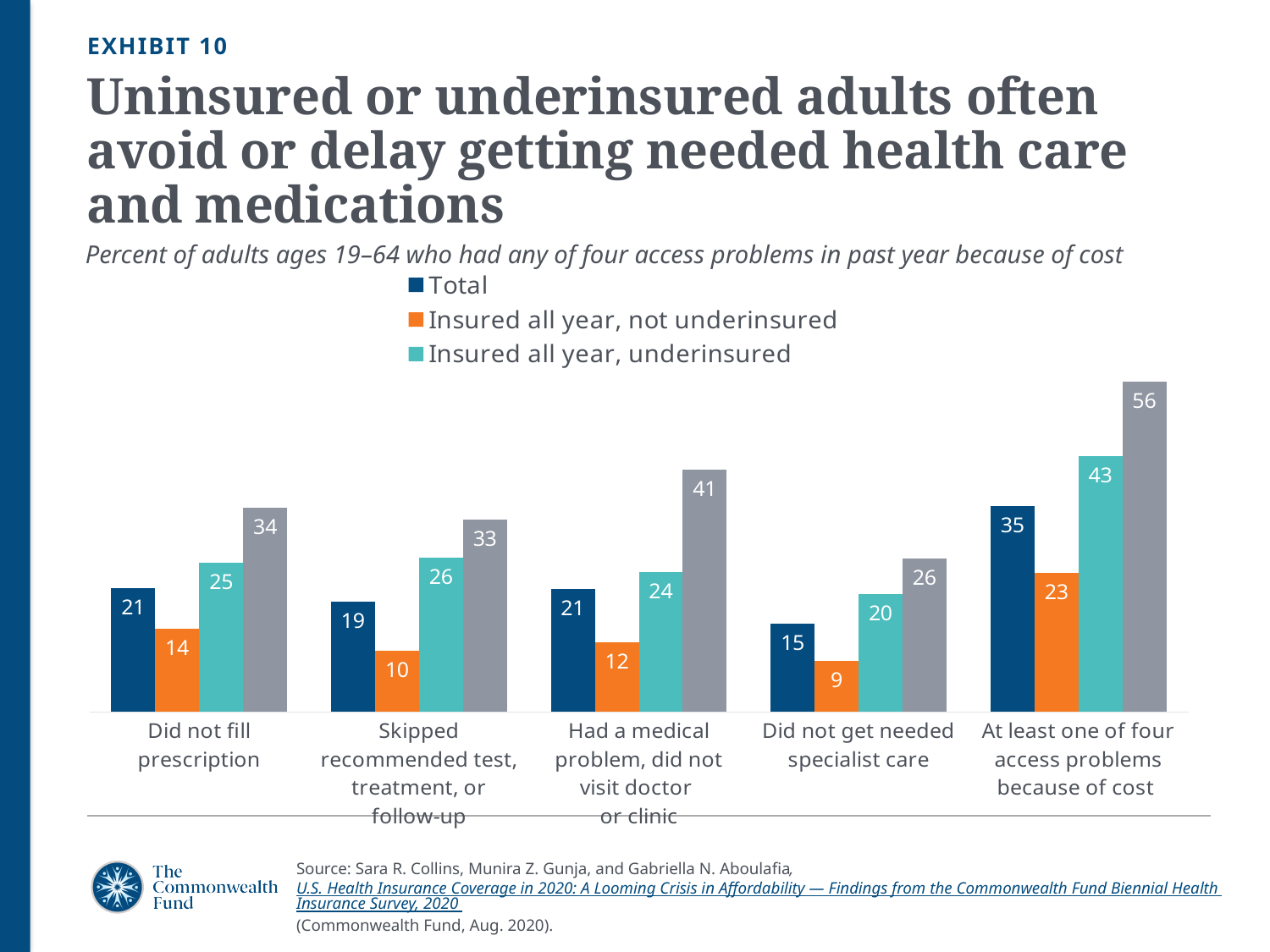
What colour are the bars for the "Insured all year, not underinsured" series? Orange How many categories are shown on the x axis? 5 What is the difference between the "Insured all year, underinsured" and "Insured all year, not underinsured" values for "Had a medical problem, did not visit doctor or clinic"? 12 What is the Total value for "Did not fill prescription"? 21 What is the value for "Insured all year, not underinsured" in the "Did not get needed specialist care" category? 9 What is the value for "Insured all year, underinsured" in the "At least one of four access problems because of cost" category? 43 Which is larger: the Total value for "Did not fill prescription" or the Total value for "Did not get needed specialist care"? Did not fill prescription How many series does the legend list? 3 What type of chart is shown on the slide? Bar chart Which category has the highest Total value? At least one of four access problems because of cost What is the Total value for "Skipped recommended test, treatment, or follow-up"? 19 Which category has the lowest value for "Insured all year, not underinsured"? Did not get needed specialist care